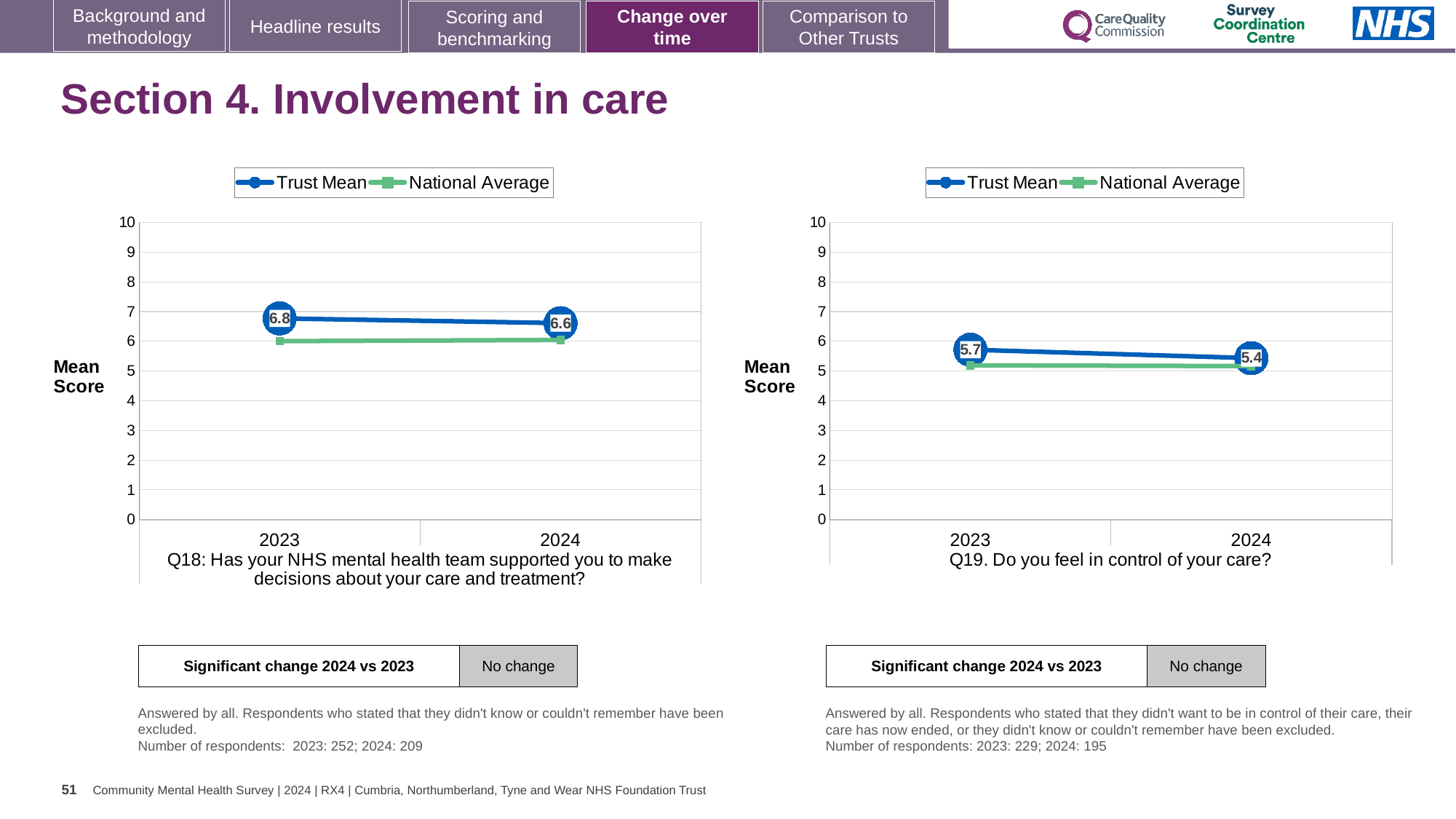
How many years are plotted on the x axis of the Q18 chart on the left? 2 What kind of chart is the Q19 chart on the right? line chart In the Q18 chart on the left, what is the Trust Mean for 2023? 6.8 How many series does the legend of the Q18 chart on the left list? 2 In the Q19 chart on the right, what is the Trust Mean for 2023? 5.7 In the Q19 chart on the right, does the Trust Mean rise or fall from 2023 to 2024? fall In the Q18 chart on the left, is the National Average for 2023 greater or less than 5? greater In the Q19 chart on the right, which is larger in 2023, the Trust Mean or the National Average? Trust Mean In the Q19 chart on the right, what is the difference between the Trust Mean in 2023 and 2024? 0.3 In the Q18 chart on the left, what is the Trust Mean for 2024? 6.6 In the Q19 chart on the right, what is the Trust Mean for 2024? 5.4 In the Q18 chart on the left, by how much did the Trust Mean change from 2023 to 2024? 0.2